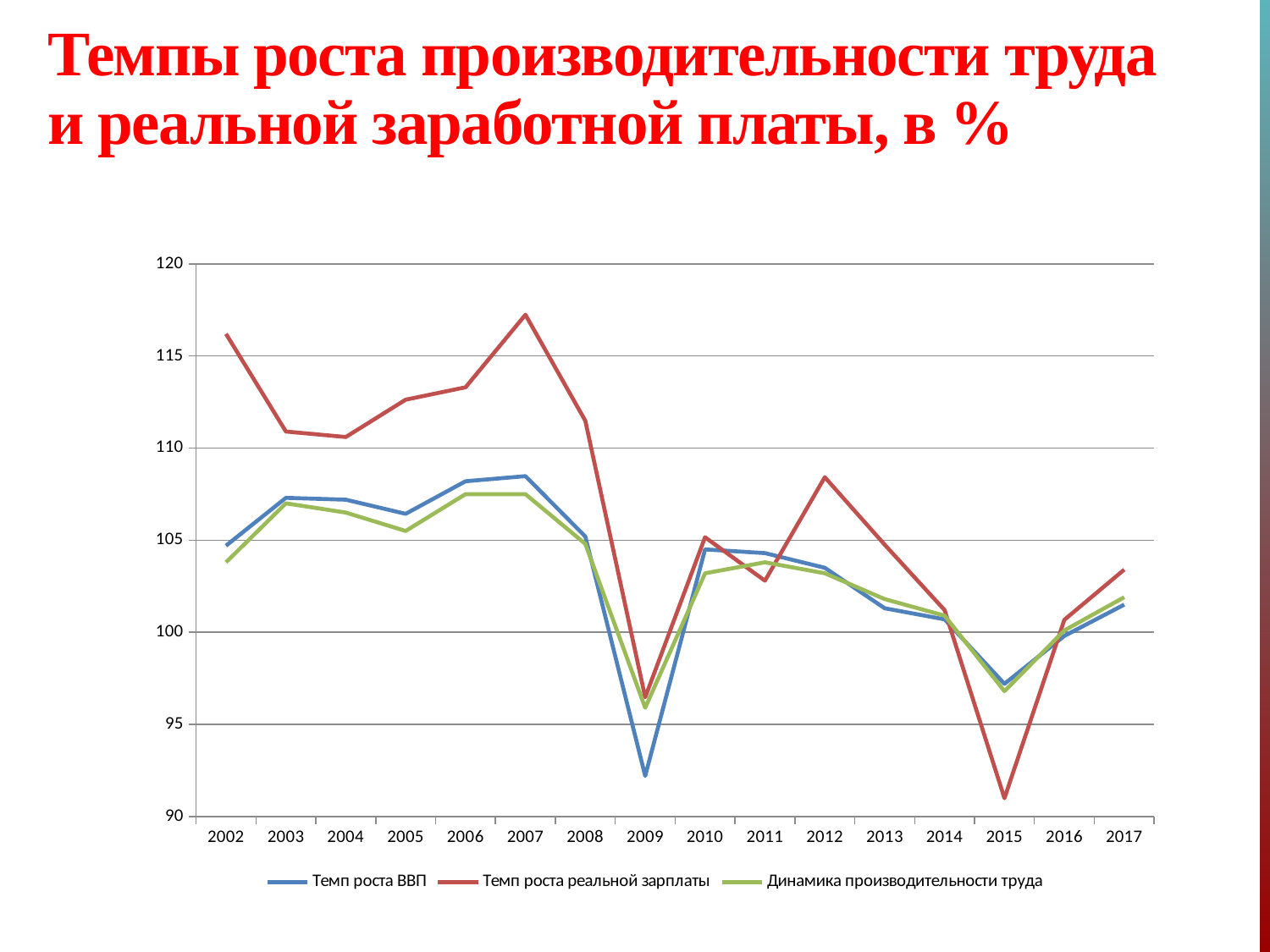
How many series does the legend list? 3 In 2009, which series has the higher value: 'Темп роста ВВП' or 'Темп роста реальной зарплаты'? Темп роста реальной зарплаты In which year does the series 'Темп роста реальной зарплаты' reach its lowest value? 2015 How many years are plotted along the x axis? 16 In which year does the series 'Темп роста ВВП' reach its lowest value? 2009 What kind of chart is shown on the slide? line chart Is the value for 'Динамика производительности труда' in 2012 greater or less than 100? greater In which year does the series 'Темп роста реальной зарплаты' reach its highest value? 2007 Is the value for 'Темп роста ВВП' in 2009 greater or less than 95? less Does the series 'Темп роста реальной зарплаты' rise or fall from 2015 to 2017? rise Is the value for 'Темп роста реальной зарплаты' in 2002 greater or less than 115? greater What is the title of the chart on the slide? Темпы роста производительности труда и реальной заработной платы, в %